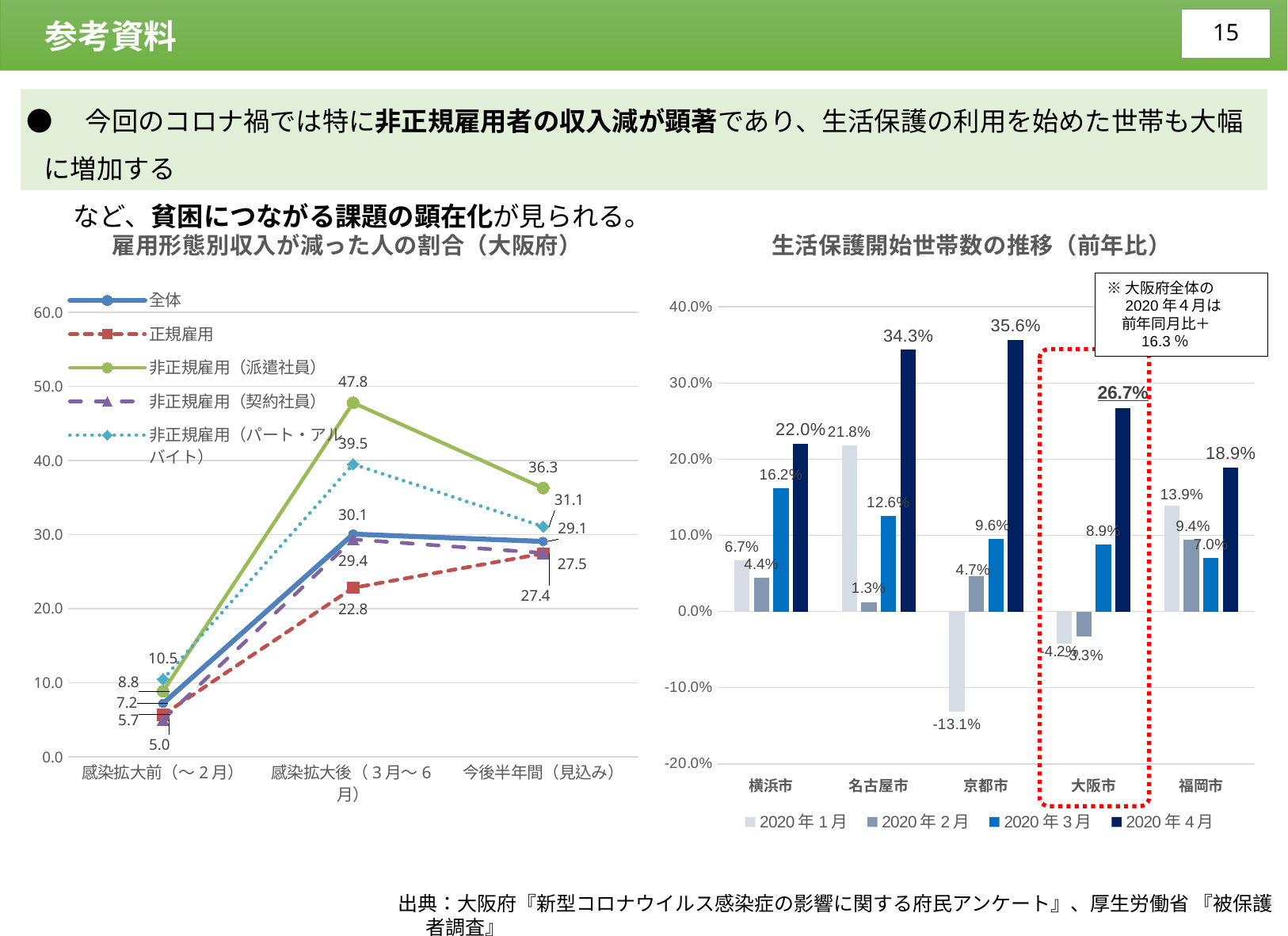
In the chart titled 生活保護開始世帯数の推移（前年比）, which city has the highest value in 2020年4月? 京都市 In the chart titled 雇用形態別収入が減った人の割合（大阪府）, what is the value for 全体 at 今後半年間（見込み）? 29.1 In the chart titled 雇用形態別収入が減った人の割合（大阪府）, which series has the lowest value at 感染拡大前（〜2月）? 非正規雇用（契約社員） What kind of chart is 生活保護開始世帯数の推移（前年比）? bar chart In the chart titled 生活保護開始世帯数の推移（前年比）, what is the value for 大阪市 in 2020年4月? 26.7% In the chart titled 雇用形態別収入が減った人の割合（大阪府）, how many series does the legend list? 5 In the chart titled 雇用形態別収入が減った人の割合（大阪府）, what is the difference between 非正規雇用（派遣社員） and 正規雇用 at 感染拡大後（3月〜6月）? 25.0 In the chart titled 雇用形態別収入が減った人の割合（大阪府）, what is the value for 非正規雇用（派遣社員） at 感染拡大後（3月〜6月）? 47.8 In the chart titled 生活保護開始世帯数の推移（前年比）, which city has the lowest value in 2020年1月? 京都市 In the chart titled 雇用形態別収入が減った人の割合（大阪府）, does the 正規雇用 series rise or fall from 感染拡大前（〜2月） to 今後半年間（見込み）? rise In the chart titled 雇用形態別収入が減った人の割合（大阪府）, which series has the highest value at 感染拡大後（3月〜6月）? 非正規雇用（派遣社員） In the chart titled 生活保護開始世帯数の推移（前年比）, which is larger: 横浜市 in 2020年3月 or 名古屋市 in 2020年3月? 横浜市 in 2020年3月